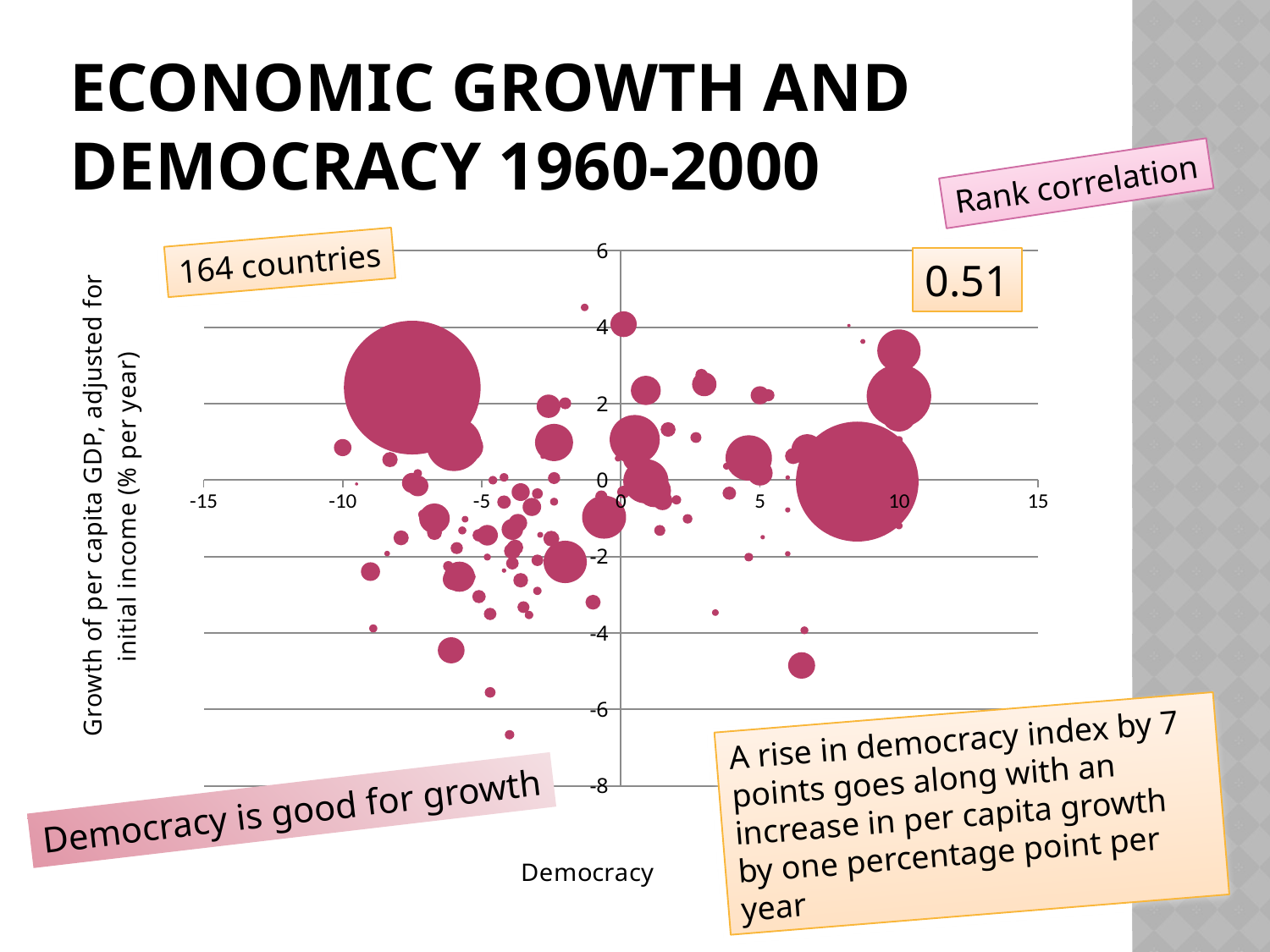
Is the growth value of the highest plotted point greater or less than 4? greater Do the growth values tend to rise or fall as the democracy index increases along the x axis? rise What is the label of the x axis of the chart? Democracy How many countries are plotted in the chart? 164 What kind of chart is shown on the slide? bubble chart What rank correlation value is shown next to the chart? 0.51 Is the growth value of the lowest plotted point greater or less than -6? less